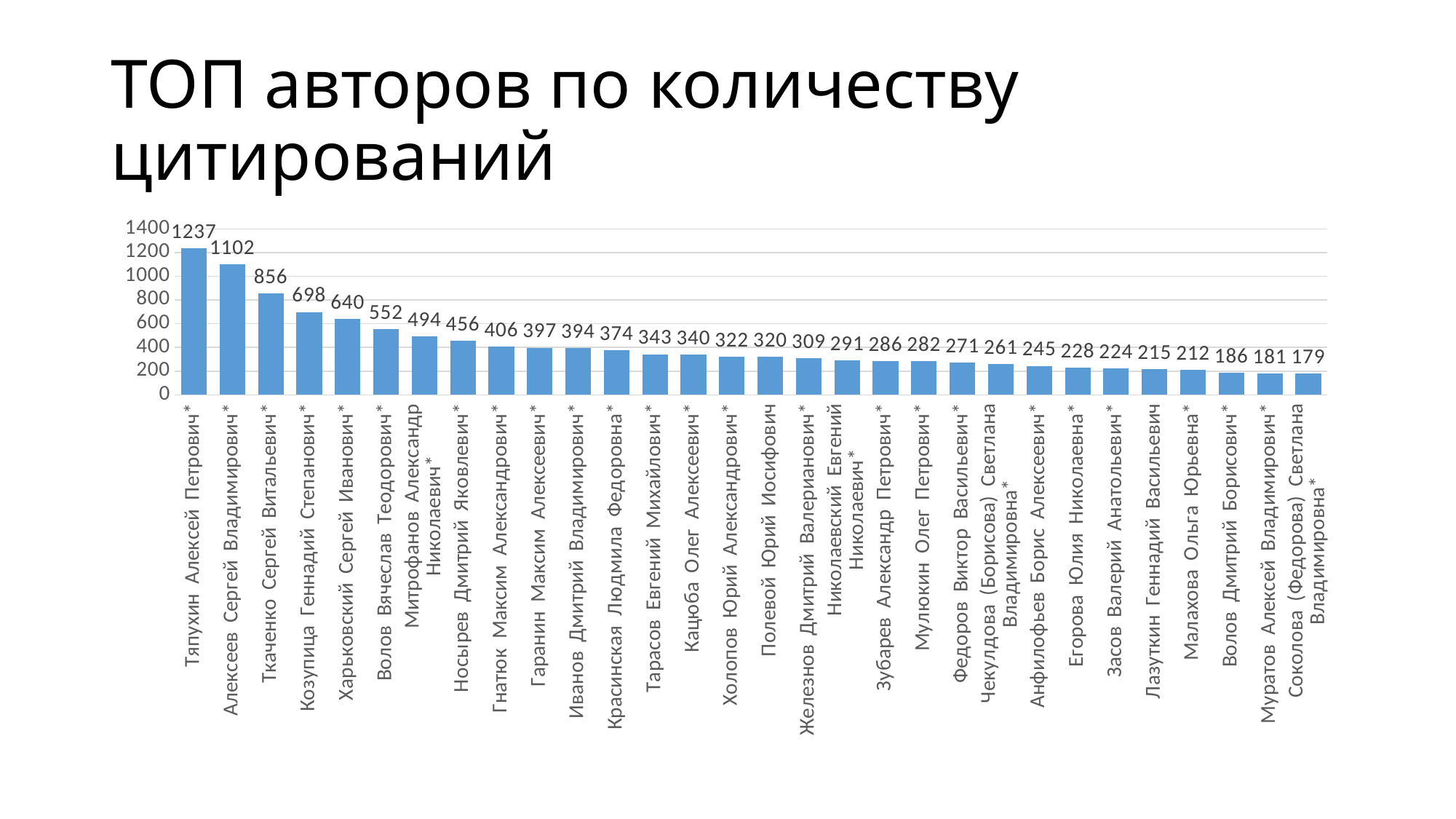
Which author has the highest number of citations? Тяпухин Алексей Петрович Who has more citations, Козупица Геннадий Степанович or Харьковский Сергей Иванович? Козупица Геннадий Степанович What is the number of citations for Ткаченко Сергей Витальевич? 856 Do the values rise or fall from left to right along the x axis? Fall What is the difference in citations between Тяпухин Алексей Петрович and Алексеев Сергей Владимирович? 135 Which author has the lowest number of citations? Соколова (Федорова) Светлана Владимировна What is the title of the chart on the slide? ТОП авторов по количеству цитирований What is the number of citations for Тяпухин Алексей Петрович? 1237 How many authors are shown in the chart? 30 What is the number of citations for Малахова Ольга Юрьевна? 212 What is the number of citations for Красинская Людмила Федоровна? 374 What type of chart is shown on the slide? Bar chart